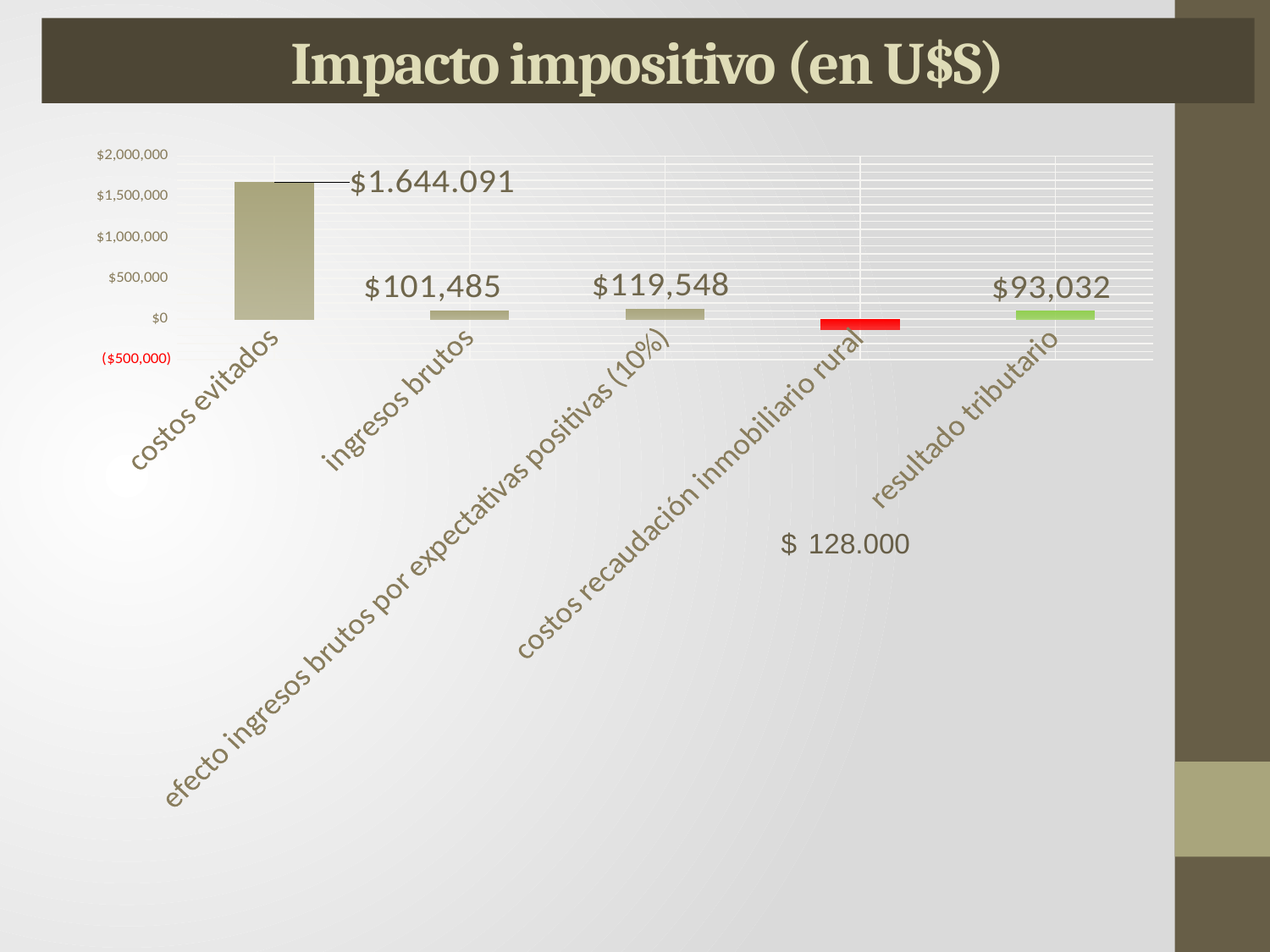
Which is larger: the value for ingresos brutos or the value for efecto ingresos brutos por expectativas positivas (10%)? efecto ingresos brutos por expectativas positivas (10%) How many categories are plotted in the chart? 5 What is the value for resultado tributario? $93,032 What is the difference between the value for efecto ingresos brutos por expectativas positivas (10%) and the value for ingresos brutos? $18,063 What is the title of the chart? Impacto impositivo (en U$S) What is the value labelled for costos recaudación inmobiliario rural? $ 128.000 What is the value for ingresos brutos? $101,485 Which category has the highest value? costos evitados What is the value for costos evitados? $1.644.091 Which category is the only one with a negative bar (below $0)? costos recaudación inmobiliario rural What is the value labelled for efecto ingresos brutos por expectativas positivas (10%)? $119,548 What kind of chart is shown on the slide? bar chart